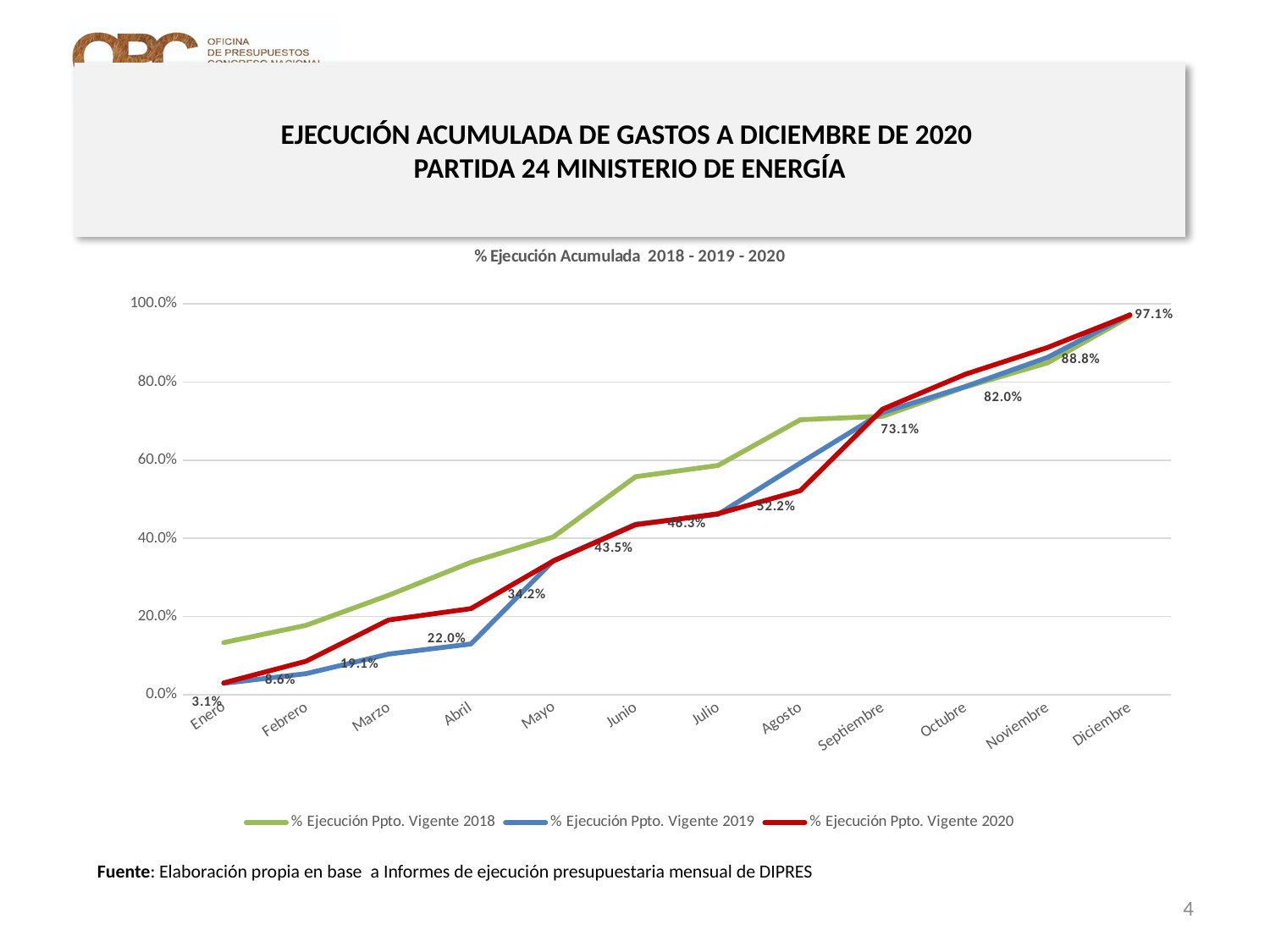
In Agosto, which series has the larger value: % Ejecución Ppto. Vigente 2018 or % Ejecución Ppto. Vigente 2020? % Ejecución Ppto. Vigente 2018 What is the value for % Ejecución Ppto. Vigente 2020 in Abril? 22.0% How many series does the legend list? 3 What is the value for % Ejecución Ppto. Vigente 2020 in Septiembre? 73.1% What is the title of the chart? % Ejecución Acumulada 2018 - 2019 - 2020 What is the difference between the 2020 values for Diciembre and Noviembre? 8.3 percentage points What kind of chart is shown on the slide? Line chart Is the value for % Ejecución Ppto. Vigente 2018 in Enero greater or less than 20.0%? less What is the value for % Ejecución Ppto. Vigente 2020 in Diciembre? 97.1% What is the difference between the 2020 values for Octubre and Septiembre? 8.9 percentage points How many months are shown along the x axis? 12 Do the values for % Ejecución Ppto. Vigente 2020 rise or fall from Enero to Diciembre? Rise